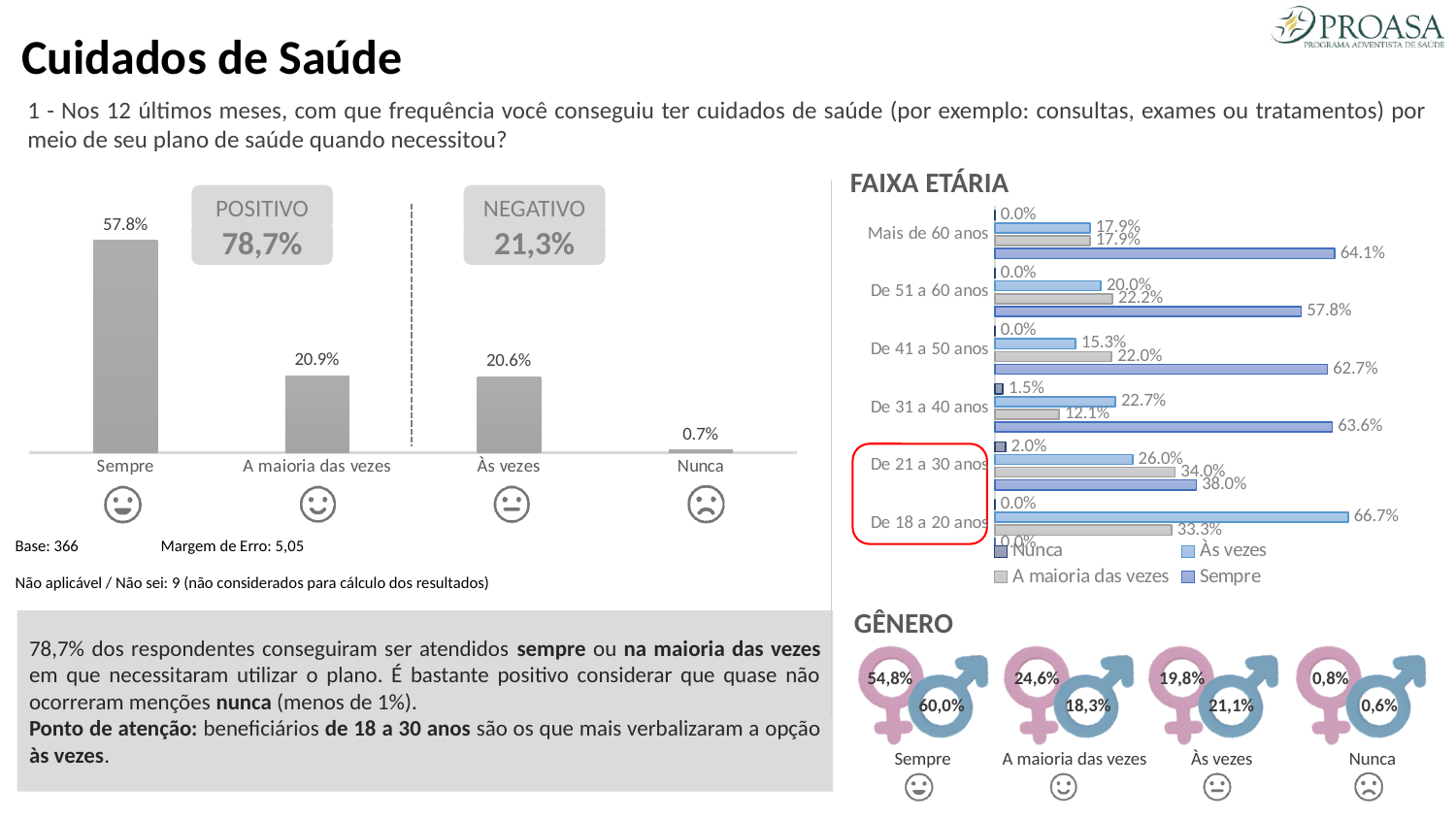
In the bar chart on the left, which category has the lowest value? Nunca In the 'FAIXA ETÁRIA' chart, what is the 'Sempre' value for 'Mais de 60 anos'? 64.1% What kind of chart is the chart on the left? Bar chart In the bar chart on the left, how many categories are shown? 4 In the 'FAIXA ETÁRIA' chart, what is the 'Às vezes' value for 'De 18 a 20 anos'? 66.7% In the 'FAIXA ETÁRIA' chart, how many series does the legend list? 4 In the 'FAIXA ETÁRIA' chart, how many age groups are shown? 6 In the 'FAIXA ETÁRIA' chart, which age group has the highest 'A maioria das vezes' value? De 21 a 30 anos In the bar chart on the left, what is the value for 'Sempre'? 57.8% In the 'FAIXA ETÁRIA' chart, what is the 'Nunca' value for 'De 31 a 40 anos'? 1.5% In the 'FAIXA ETÁRIA' chart, which is larger for 'De 21 a 30 anos': 'Sempre' or 'Às vezes'? Sempre In the bar chart on the left, what is the difference between 'Sempre' and 'A maioria das vezes'? 36.9 percentage points